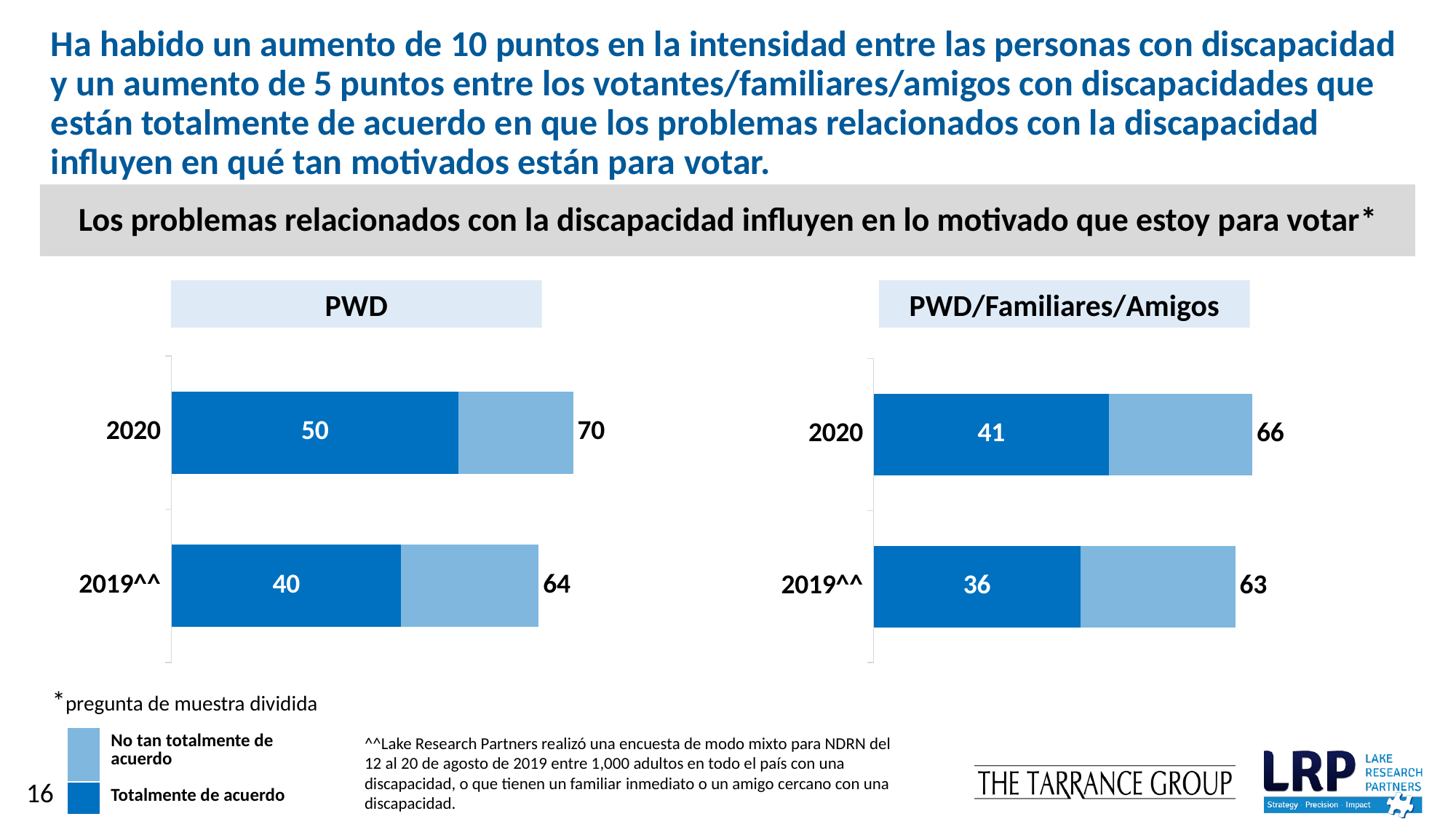
In the PWD/Familiares/Amigos chart, what is the total value shown for 2020? 66 How many bars are in the PWD/Familiares/Amigos chart? 2 In the PWD chart, what is the total value shown for 2019^^? 64 What kind of chart is the PWD chart? Stacked bar chart In the PWD chart, by how much did the 'Totalmente de acuerdo' value increase from 2019^^ to 2020? 10 In the PWD chart, what is the 'Totalmente de acuerdo' value for 2020? 50 In the PWD chart, which year has the higher 'Totalmente de acuerdo' value, 2020 or 2019^^? 2020 How many series does the legend list? 2 Which legend entry is shown in dark blue? Totalmente de acuerdo In the PWD/Familiares/Amigos chart, what is the difference between the 2020 total and the 2019^^ total? 3 In the PWD/Familiares/Amigos chart, what is the 'Totalmente de acuerdo' value for 2019^^? 36 Which chart shows the higher 'Totalmente de acuerdo' value for 2020, PWD or PWD/Familiares/Amigos? PWD